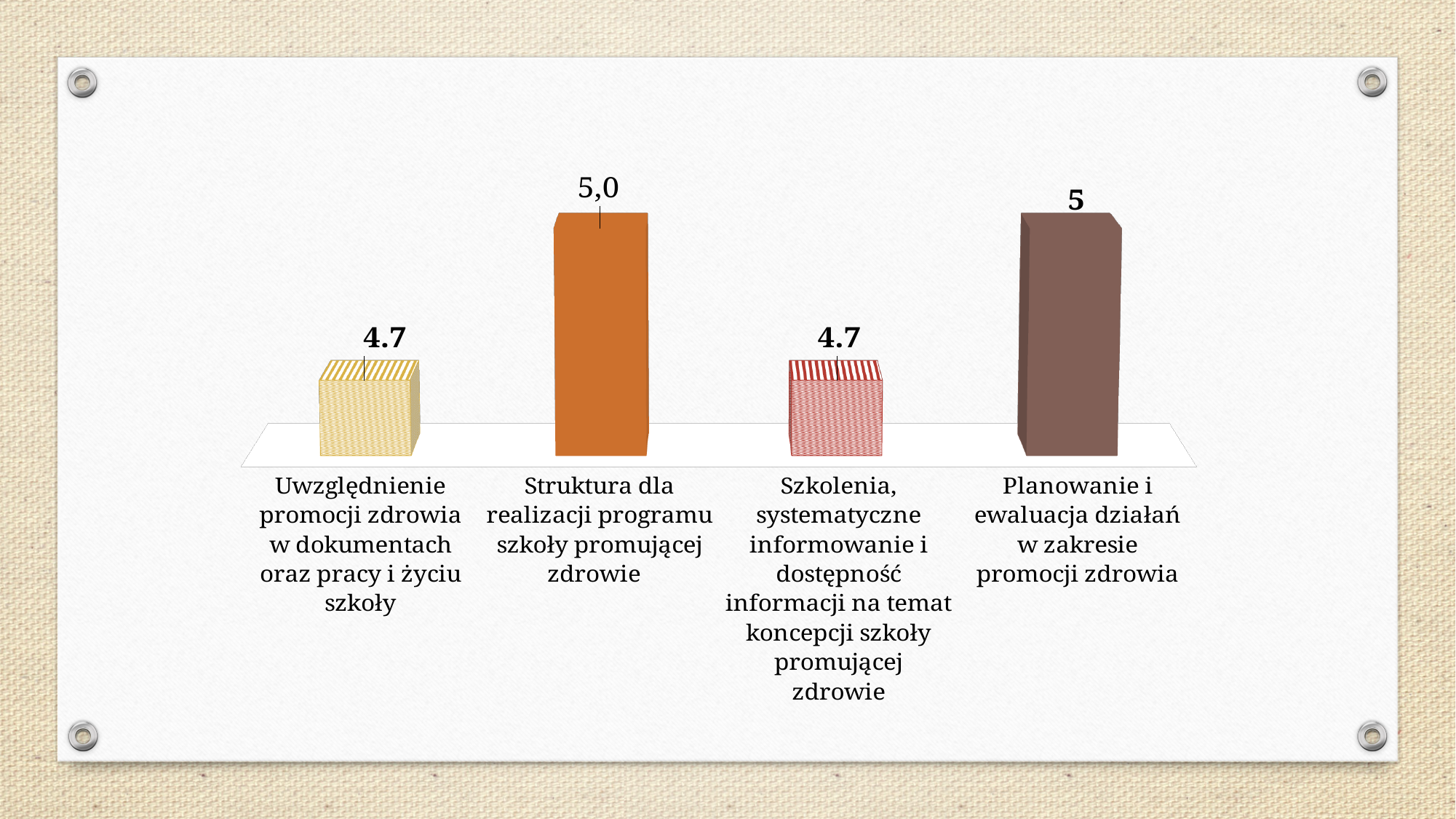
What is the value for "Planowanie i ewaluacja działań w zakresie promocji zdrowia"? 5 What is the value for "Uwzględnienie promocji zdrowia w dokumentach oraz pracy i życiu szkoły"? 4.7 What colour is the bar for "Struktura dla realizacji programu szkoły promującej zdrowie"? Orange How many categories are shown in the chart? 4 Does the chart have a legend? No What is the value for "Szkolenia, systematyczne informowanie i dostępność informacji na temat koncepcji szkoły promującej zdrowie"? 4.7 What is the difference between the value for "Struktura dla realizacji programu szkoły promującej zdrowie" and the value for "Szkolenia, systematyczne informowanie i dostępność informacji na temat koncepcji szkoły promującej zdrowie"? 0.3 What is the difference between the value for "Planowanie i ewaluacja działań w zakresie promocji zdrowia" and the value for "Uwzględnienie promocji zdrowia w dokumentach oraz pracy i życiu szkoły"? 0.3 What kind of chart is shown on the slide? Bar chart What is the value for "Struktura dla realizacji programu szkoły promującej zdrowie"? 5,0 Which is larger: the value for "Struktura dla realizacji programu szkoły promującej zdrowie" or the value for "Uwzględnienie promocji zdrowia w dokumentach oraz pracy i życiu szkoły"? Struktura dla realizacji programu szkoły promującej zdrowie Which is larger: the value for "Szkolenia, systematyczne informowanie i dostępność informacji na temat koncepcji szkoły promującej zdrowie" or the value for "Planowanie i ewaluacja działań w zakresie promocji zdrowia"? Planowanie i ewaluacja działań w zakresie promocji zdrowia